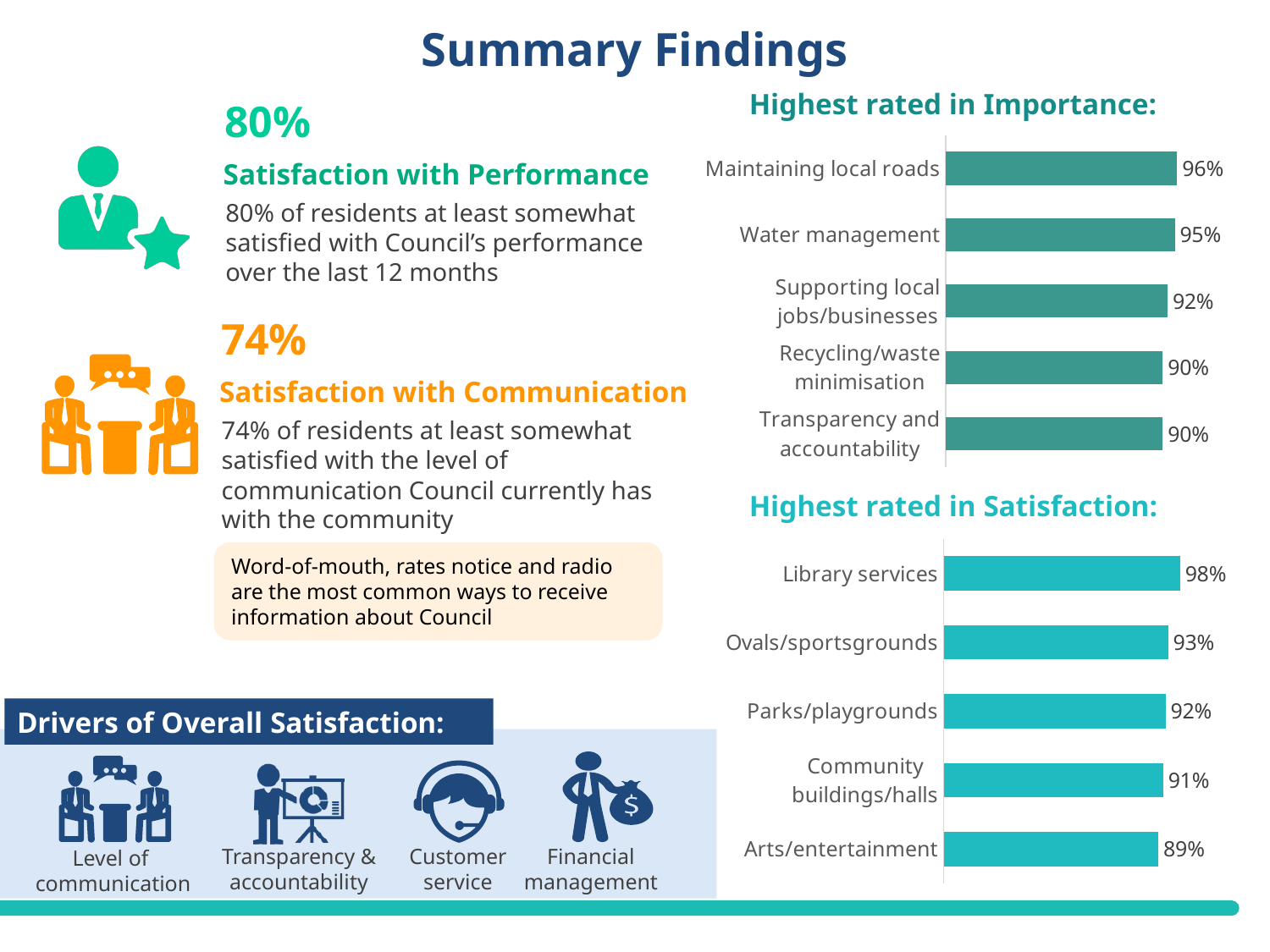
In the 'Highest rated in Satisfaction' chart, which is larger, Ovals/sportsgrounds or Parks/playgrounds? Ovals/sportsgrounds In the 'Highest rated in Importance' chart, what is the value for Recycling/waste minimisation? 90% In the 'Highest rated in Importance' chart, what is the difference between Maintaining local roads and Supporting local jobs/businesses? 4% What is the title of the chart on the upper right of the slide? Highest rated in Importance: In the 'Highest rated in Satisfaction' chart, what is the difference between Library services and Community buildings/halls? 7% In the 'Highest rated in Importance' chart, what is the value for Water management? 95% In the 'Highest rated in Importance' chart, which category has the highest value? Maintaining local roads In the 'Highest rated in Satisfaction' chart, which category has the lowest value? Arts/entertainment In the 'Highest rated in Satisfaction' chart, what is the value for Library services? 98% What kind of chart is the 'Highest rated in Satisfaction' chart? Bar chart In the 'Highest rated in Importance' chart, how many categories are shown? 5 In the 'Highest rated in Satisfaction' chart, do the values rise or fall from top to bottom? Fall